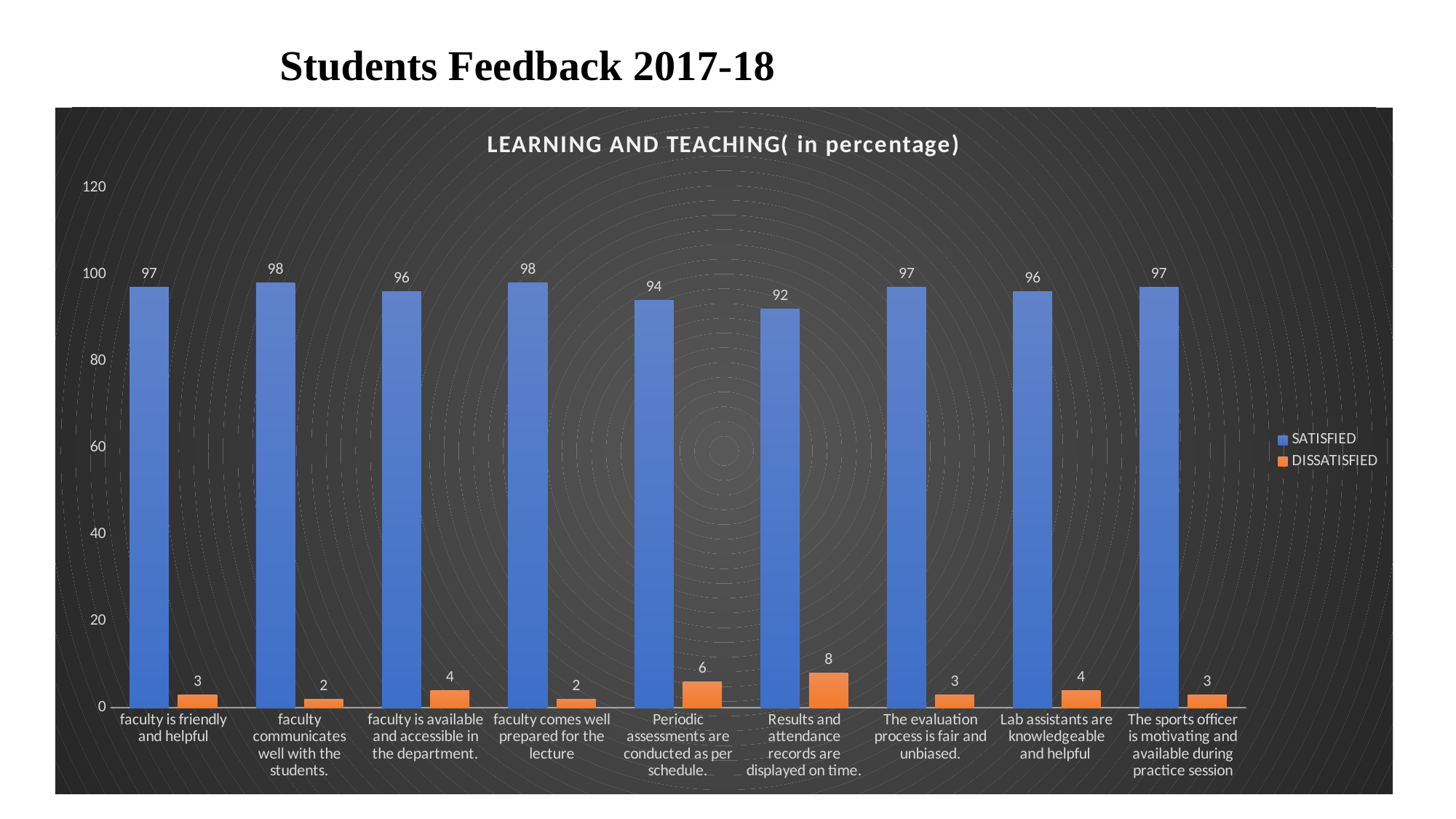
Is the SATISFIED value for "The evaluation process is fair and unbiased." greater or less than 80? greater What is the SATISFIED value for "Results and attendance records are displayed on time."? 92 What is the DISSATISFIED value for "Periodic assessments are conducted as per schedule."? 6 How many series does the legend list? 2 Which is larger, the DISSATISFIED value for "Lab assistants are knowledgeable and helpful" or for "faculty communicates well with the students."? Lab assistants are knowledgeable and helpful Which category has the lowest SATISFIED value? Results and attendance records are displayed on time. What is the difference between the SATISFIED values for "faculty comes well prepared for the lecture" and "Periodic assessments are conducted as per schedule."? 4 What kind of chart is shown on the slide? bar chart How many categories are shown on the x axis? 9 Which category has the highest DISSATISFIED value? Results and attendance records are displayed on time. What is the title of the chart? LEARNING AND TEACHING( in percentage) What is the SATISFIED value for "faculty is friendly and helpful"? 97